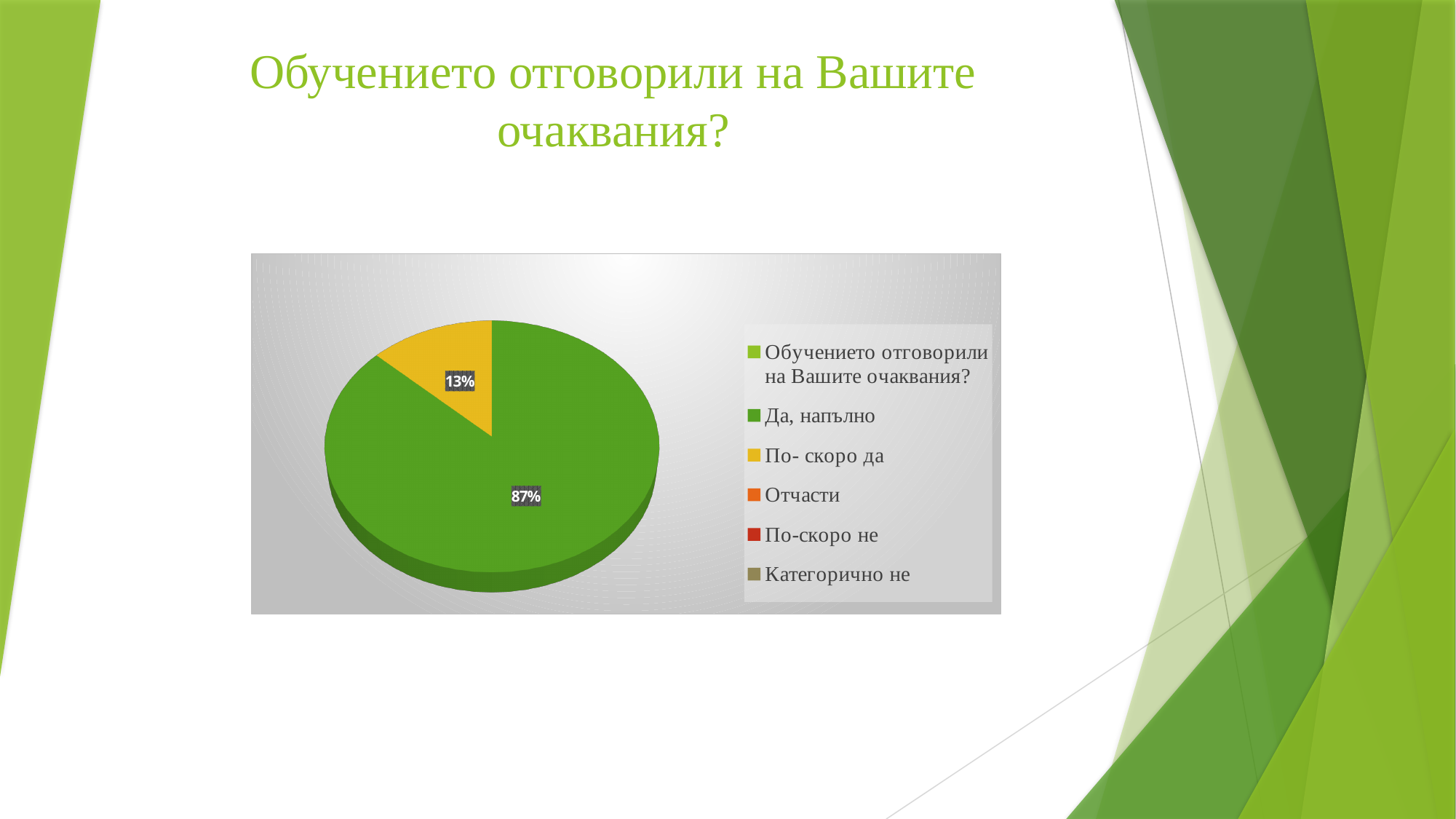
What colour is the slice for "По- скоро да"? Yellow Which category has the largest slice of the pie? Да, напълно Which is larger: the slice for "Да, напълно" or the slice for "По- скоро да"? Да, напълно Of the two slices shown in the pie, which is the smaller one? По- скоро да How many entries does the legend list? 6 How many slices with data labels are visible in the pie? 2 What kind of chart is shown on the slide? Pie chart By how many percentage points does the "Да, напълно" slice exceed the "По- скоро да" slice? 74 percentage points What percentage of the pie is labelled for "Да, напълно"? 87% What share of the pie does the green slice represent? 87% What percentage of the pie is labelled for "По- скоро да"? 13% What is the title of the slide? Обучението отговорили на Вашите очаквания?